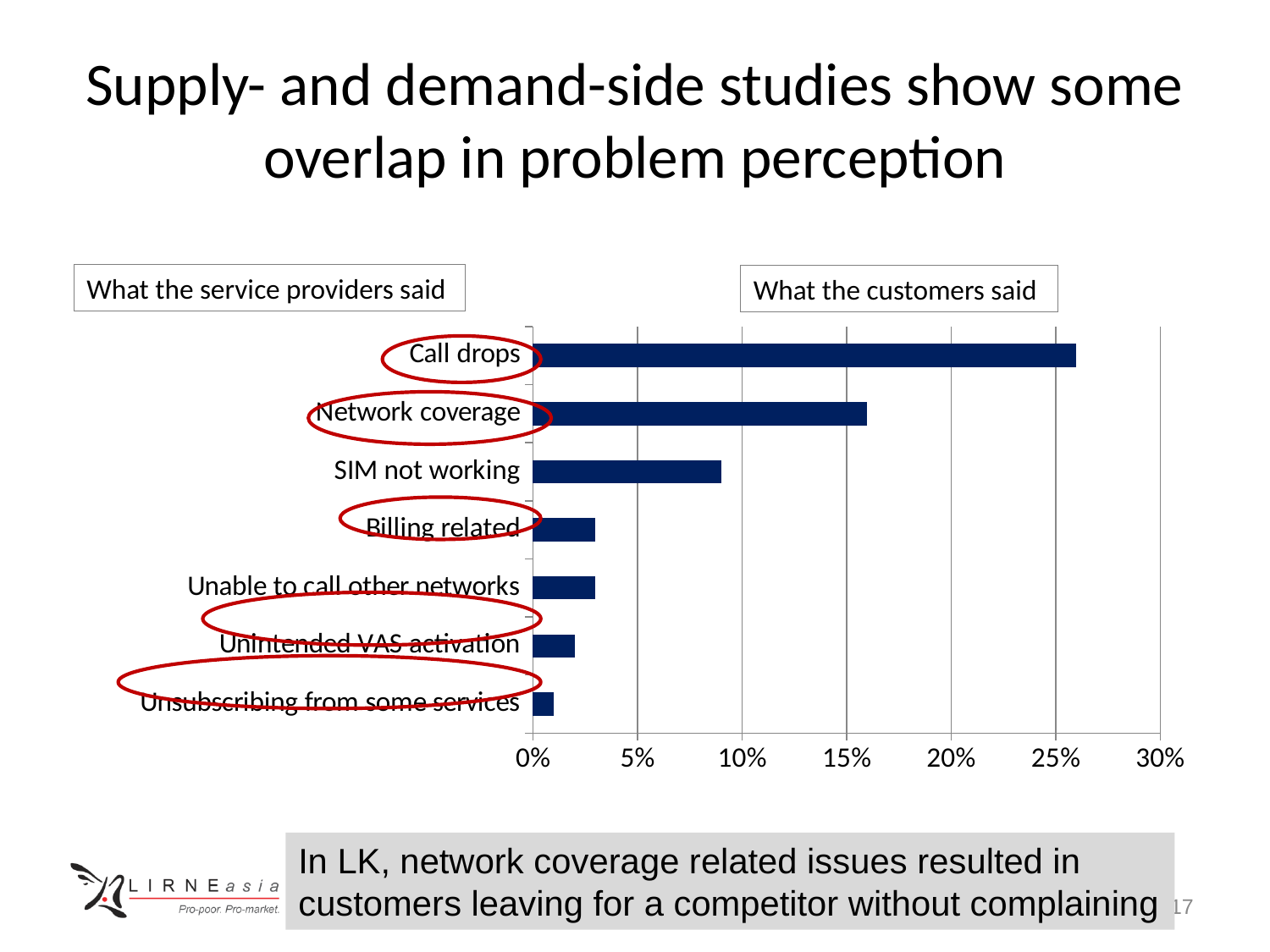
What kind of chart is shown on the slide? bar chart Is the value for Billing related greater or less than 5%? less Which is larger, the value for SIM not working or the value for Unintended VAS activation? SIM not working How many categories (problem types) are plotted in the chart? 7 Which category has the longest bar in the chart? Call drops What is the highest value shown on the horizontal axis of the chart? 30% Is the value for Call drops greater or less than 25%? greater Is the value for SIM not working greater or less than 10%? less What colour are the bars in the chart? dark blue Which category has the shortest bar in the chart? Unsubscribing from some services Which is larger, the value for Call drops or the value for Network coverage? Call drops